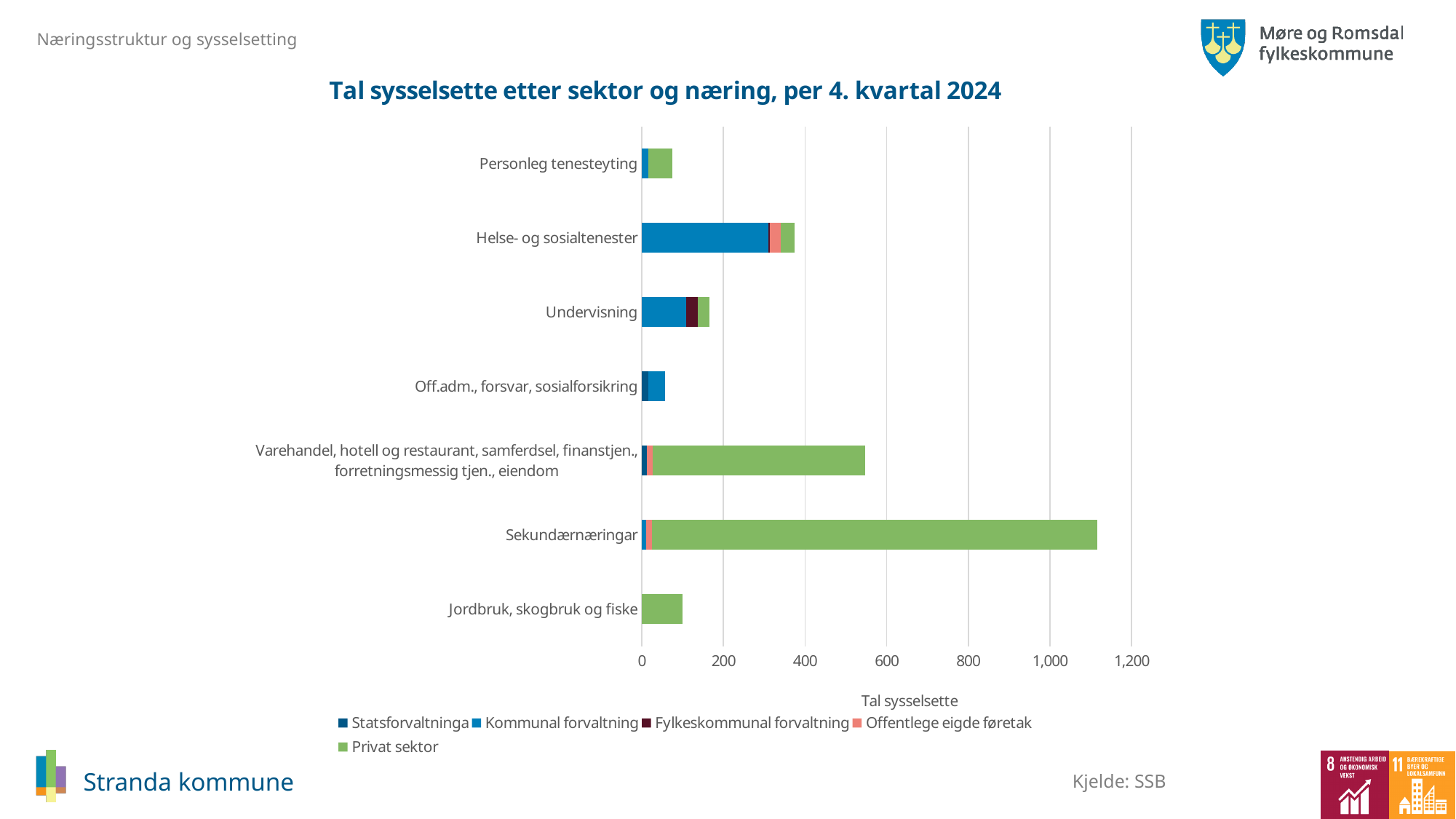
How many categories (næringar) are shown on the y axis of the chart? 7 How many series does the legend list? 5 Is the total value for Helse- og sosialtenester greater or less than 400? less Is the total value for Sekundærnæringar greater or less than 1,000? greater Is the total value for Undervisning greater or less than 200? less What is the title of the chart? Tal sysselsette etter sektor og næring, per 4. kvartal 2024 Which series makes up most of the bar for Helse- og sosialtenester? Kommunal forvaltning Which has a larger total, Helse- og sosialtenester or Undervisning? Helse- og sosialtenester What kind of chart is shown on the slide? Stacked bar chart Which category has the longest bar in total? Sekundærnæringar